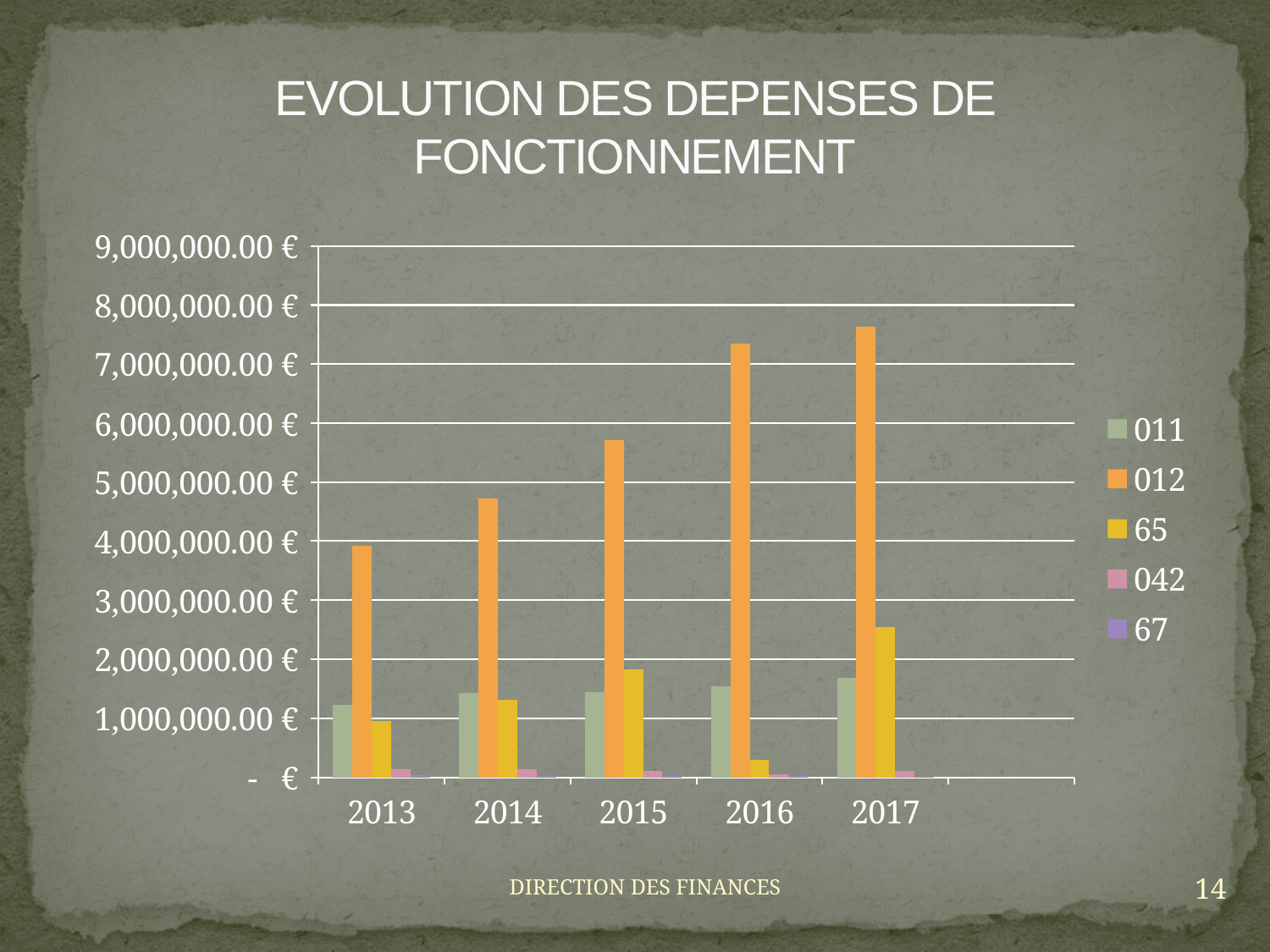
In 2015, which series has the larger value, 011 or 65? 65 Is the value for series 65 in 2017 greater or less than 2,000,000.00 €? greater How many series does the legend list? 5 In which year is the value for series 65 the lowest? 2016 Does the value for series 012 rise or fall from 2013 to 2017? rise What kind of chart is shown on the slide? bar chart In which year is the value for series 012 the highest? 2017 Is the value for series 012 in 2016 greater or less than 7,000,000.00 €? greater In which year is the value for series 012 the lowest? 2013 How many years are shown on the x axis? 5 What is the title of the chart? EVOLUTION DES DEPENSES DE FONCTIONNEMENT